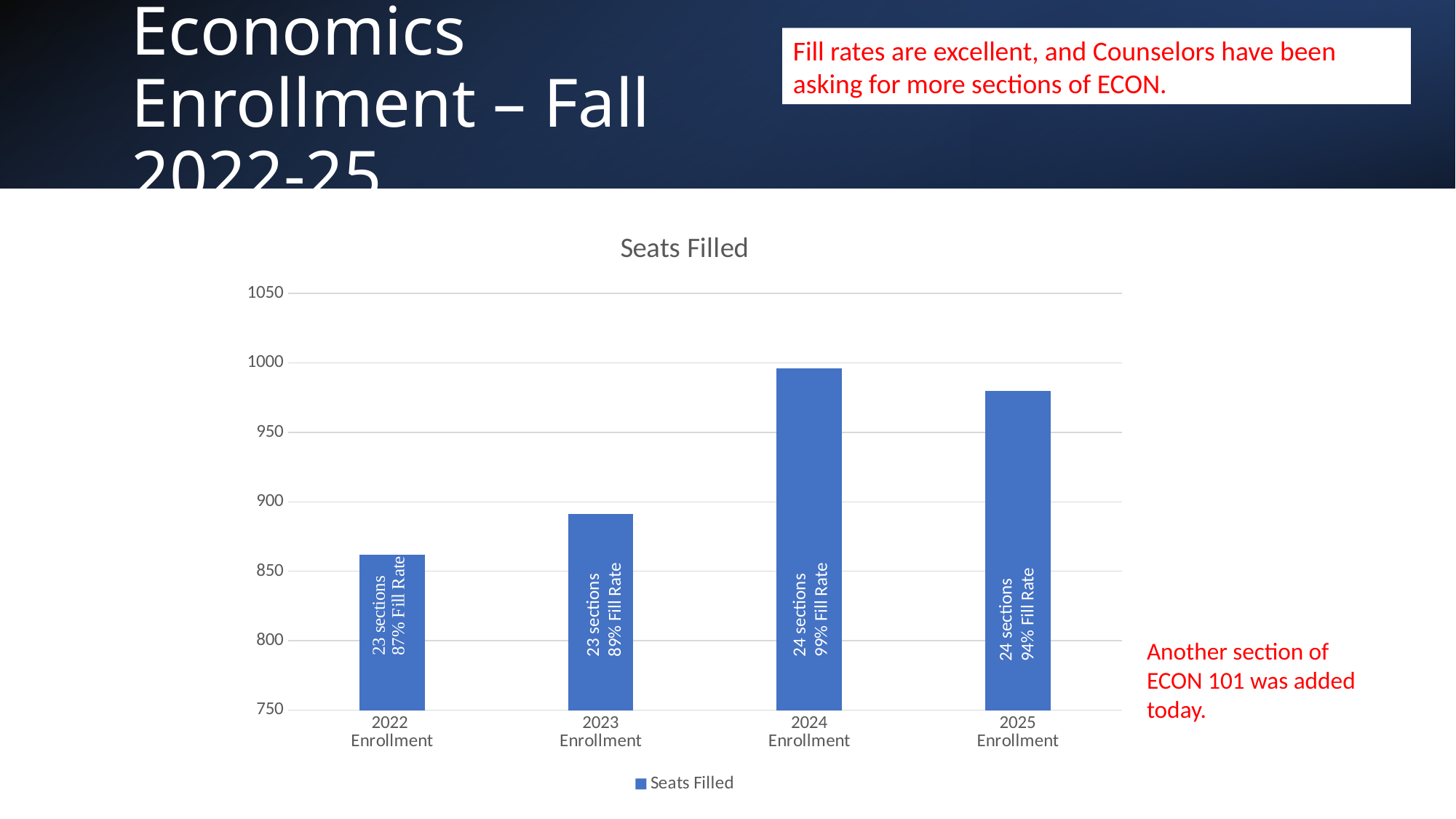
What is the title of the chart? Seats Filled How many sections are printed on the bar for 2025 Enrollment? 24 sections Is the Seats Filled value for 2023 Enrollment greater or less than 900? less What fill rate is printed on the bar for 2024 Enrollment? 99% Fill Rate Which category has the lowest Seats Filled value? 2022 Enrollment How many categories are plotted on the x axis of the chart? 4 Which has more seats filled, 2024 Enrollment or 2025 Enrollment? 2024 Enrollment Is the Seats Filled value for 2022 Enrollment greater or less than 850? greater How many series does the chart legend list? 1 Is the Seats Filled value for 2024 Enrollment greater or less than 950? greater What kind of chart is shown on the slide? bar chart Which category has the highest Seats Filled value? 2024 Enrollment